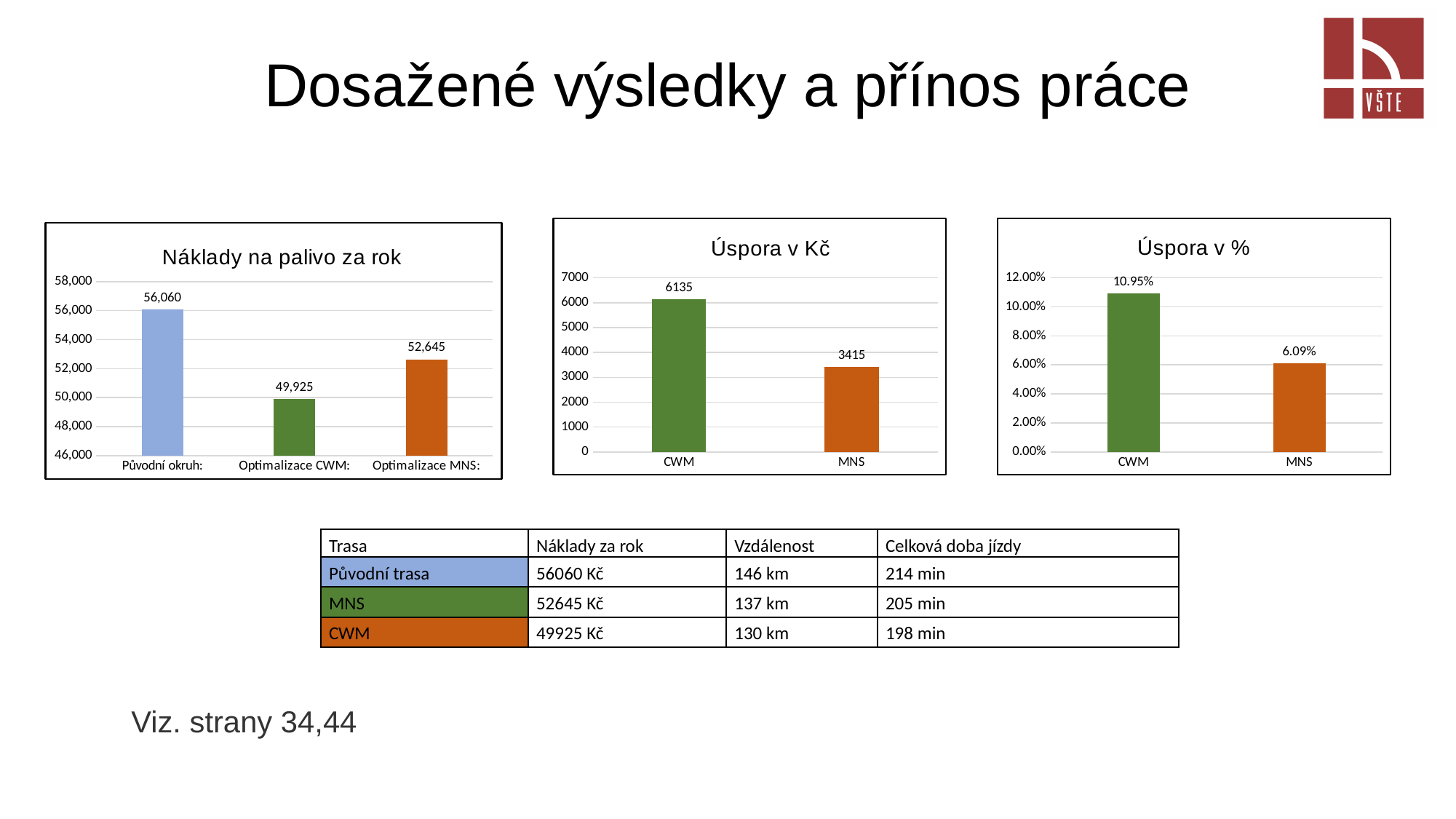
In the 'Úspora v %' chart, which is larger, CWM or MNS? CWM In the 'Úspora v %' chart, what is the value for CWM? 10.95% In the 'Náklady na palivo za rok' chart, which category has the lowest value? Optimalizace CWM: In the 'Náklady na palivo za rok' chart, what is the value for Původní okruh? 56,060 In the 'Úspora v Kč' chart, what is the difference between CWM and MNS? 2720 In the 'Úspora v Kč' chart, which category has the highest value? CWM In the 'Úspora v %' chart, is the value for MNS greater or less than 8.00%? less In the 'Náklady na palivo za rok' chart, how many categories are shown? 3 In the 'Náklady na palivo za rok' chart, what is the difference between Původní okruh and Optimalizace CWM? 6,135 In the 'Úspora v Kč' chart, what is the value for MNS? 3415 What is the title of the leftmost chart on the slide? Náklady na palivo za rok What kind of chart is the 'Úspora v Kč' chart? bar chart